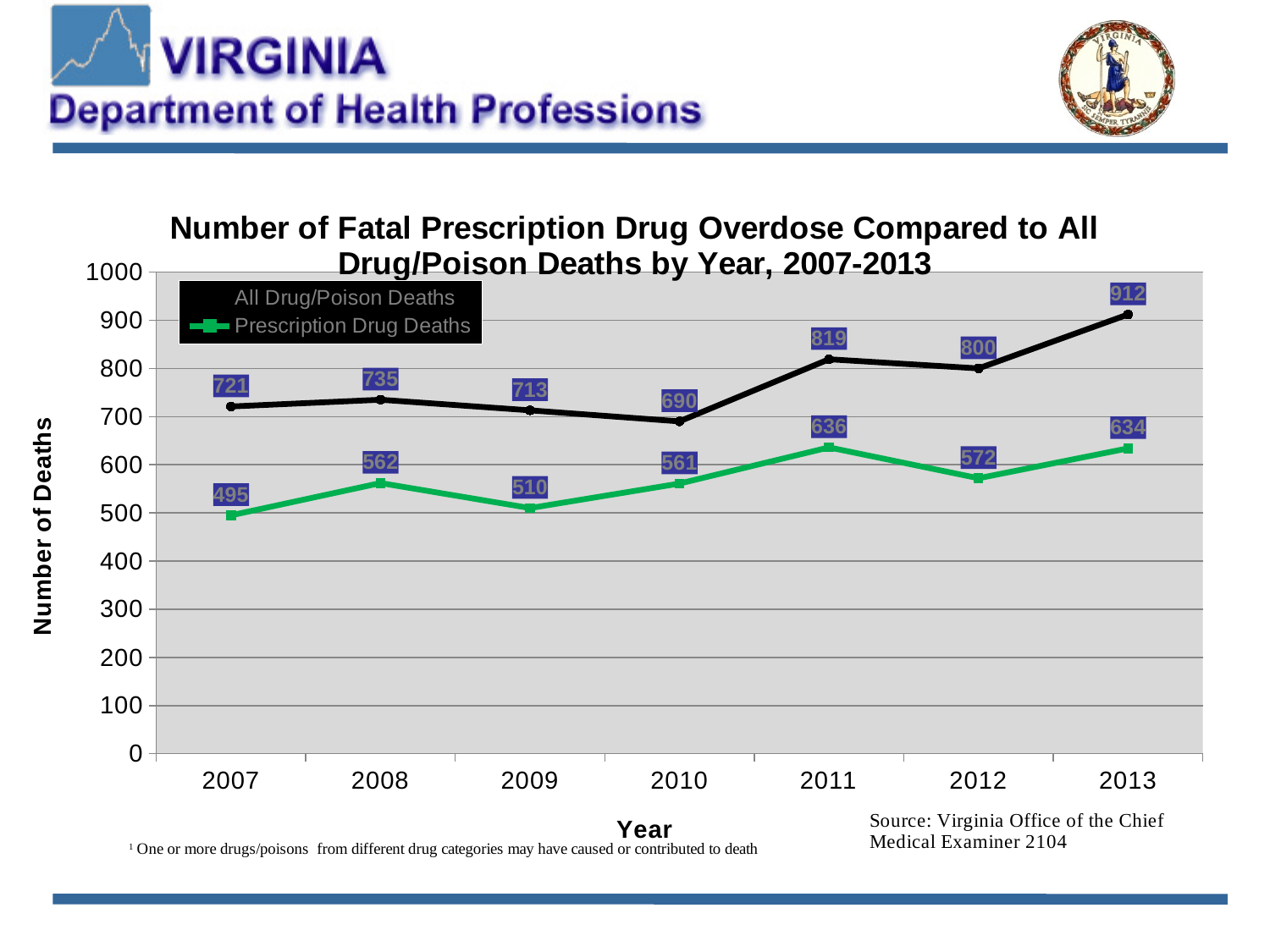
In which year is Prescription Drug Deaths lowest? 2007 What is the value for Prescription Drug Deaths in 2007? 495 Is the value for All Drug/Poison Deaths in 2011 greater or less than 800? greater What kind of chart is this? line chart How many series does the legend list? 2 In which year is All Drug/Poison Deaths highest? 2013 What is the difference between All Drug/Poison Deaths and Prescription Drug Deaths in 2013? 278 Which is larger: Prescription Drug Deaths in 2008 or in 2009? 2008 What is the value for Prescription Drug Deaths in 2011? 636 How many years are shown on the x axis? 7 What is the value for All Drug/Poison Deaths in 2013? 912 Does All Drug/Poison Deaths rise or fall from 2012 to 2013? rise